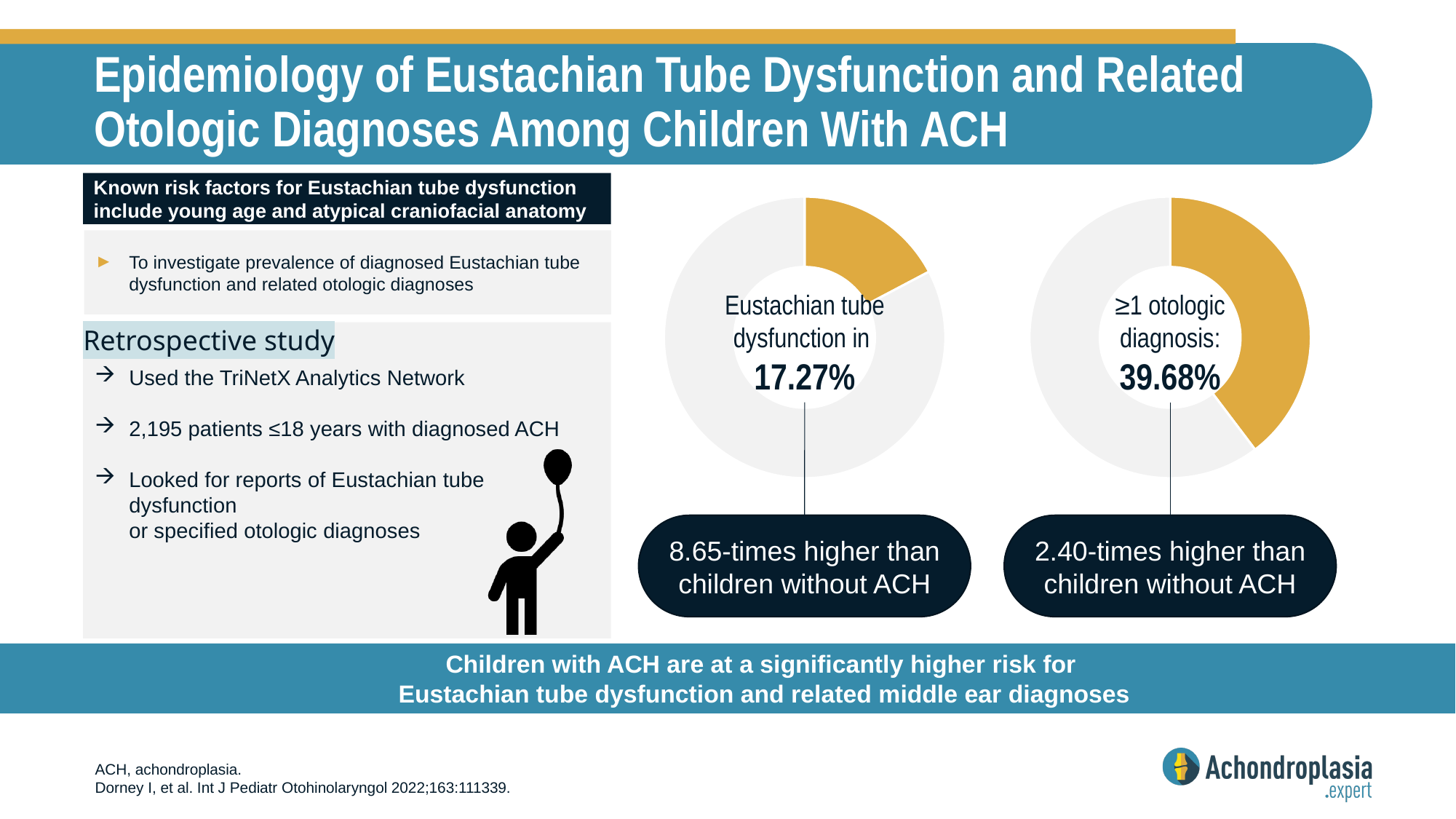
In the right donut chart, what share of the ring is filled in gold for ≥1 otologic diagnosis? 39.68% What colour is used for the highlighted segment in both donut charts? Gold (yellow-orange) What kind of chart is used on the right side of the slide to show the prevalence figures? Donut (pie) chart In the left donut chart, what share of the ring is filled in gold for Eustachian tube dysfunction? 17.27% According to the callout below the right donut chart, how many times higher is the rate of ≥1 otologic diagnosis in children with ACH than in children without ACH? 2.40-times higher According to the callout below the left donut chart, how many times higher is Eustachian tube dysfunction in children with ACH than in children without ACH? 8.65-times higher Which of the two donut charts has the smaller highlighted segment? Eustachian tube dysfunction (left chart) What is the difference in percentage points between the ≥1 otologic diagnosis share (39.68%) and the Eustachian tube dysfunction share (17.27%)? 22.41 percentage points How many donut charts are shown on the slide? 2 In the left donut chart, what percentage of children with ACH had Eustachian tube dysfunction? 17.27% In the right donut chart, what percentage of children with ACH had ≥1 otologic diagnosis? 39.68% Which donut chart shows the larger highlighted share: Eustachian tube dysfunction or ≥1 otologic diagnosis? ≥1 otologic diagnosis